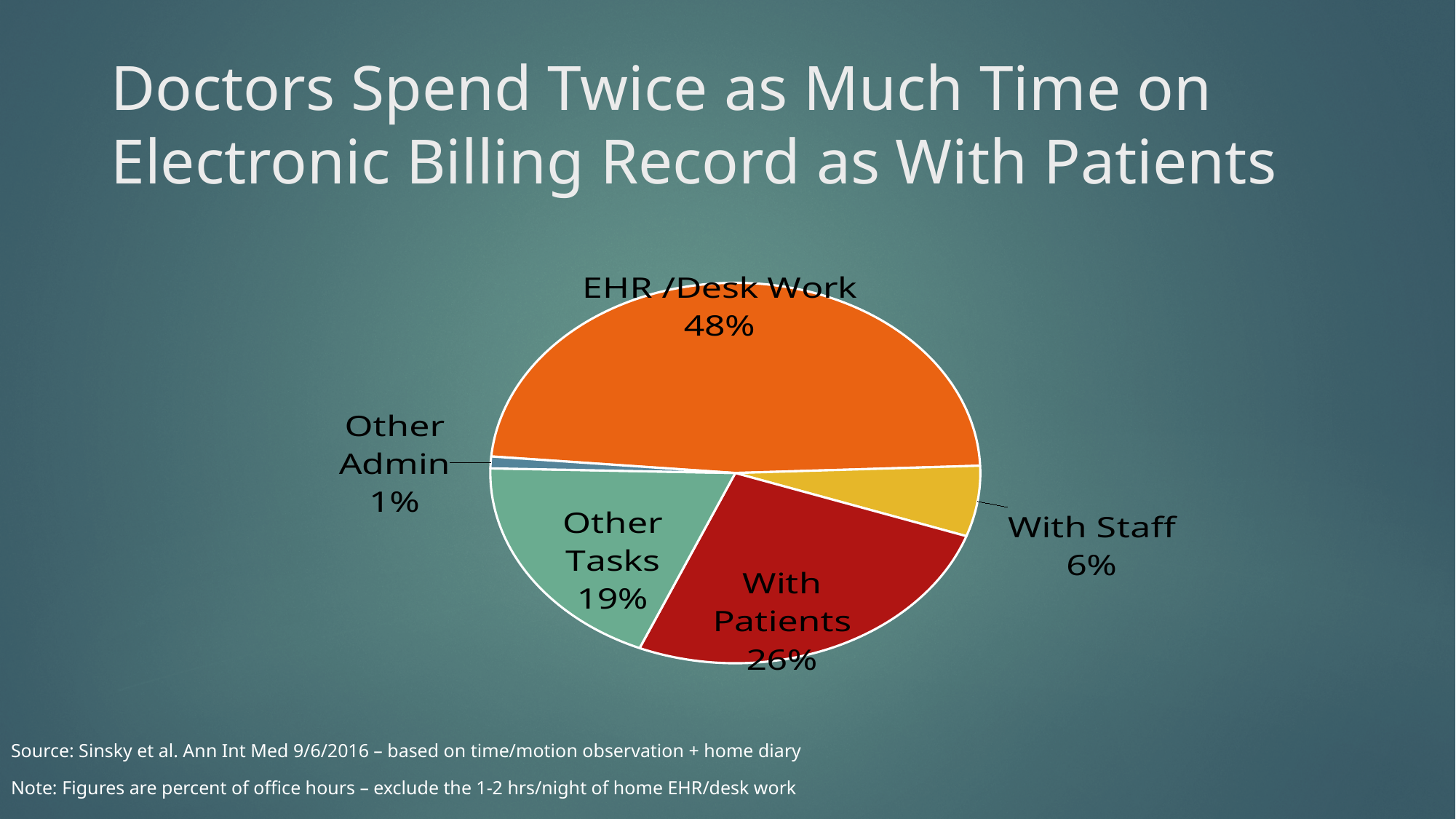
What percentage of office hours is spent on Other Admin? 1% Which is larger, the share for Other Tasks or the share for With Staff? Other Tasks Which category takes the largest share of the pie? EHR /Desk Work How many categories are shown in the pie chart? 5 What percentage of office hours is spent With Patients? 26% Which category takes the smallest share of the pie? Other Admin What kind of chart is shown on the slide? Pie chart What is the difference in percentage points between EHR /Desk Work and With Patients? 22 What colour is the With Patients slice? Red What percentage of office hours is spent on EHR /Desk Work? 48% What percentage of office hours is spent on Other Tasks? 19% What percentage of office hours is spent With Staff? 6%